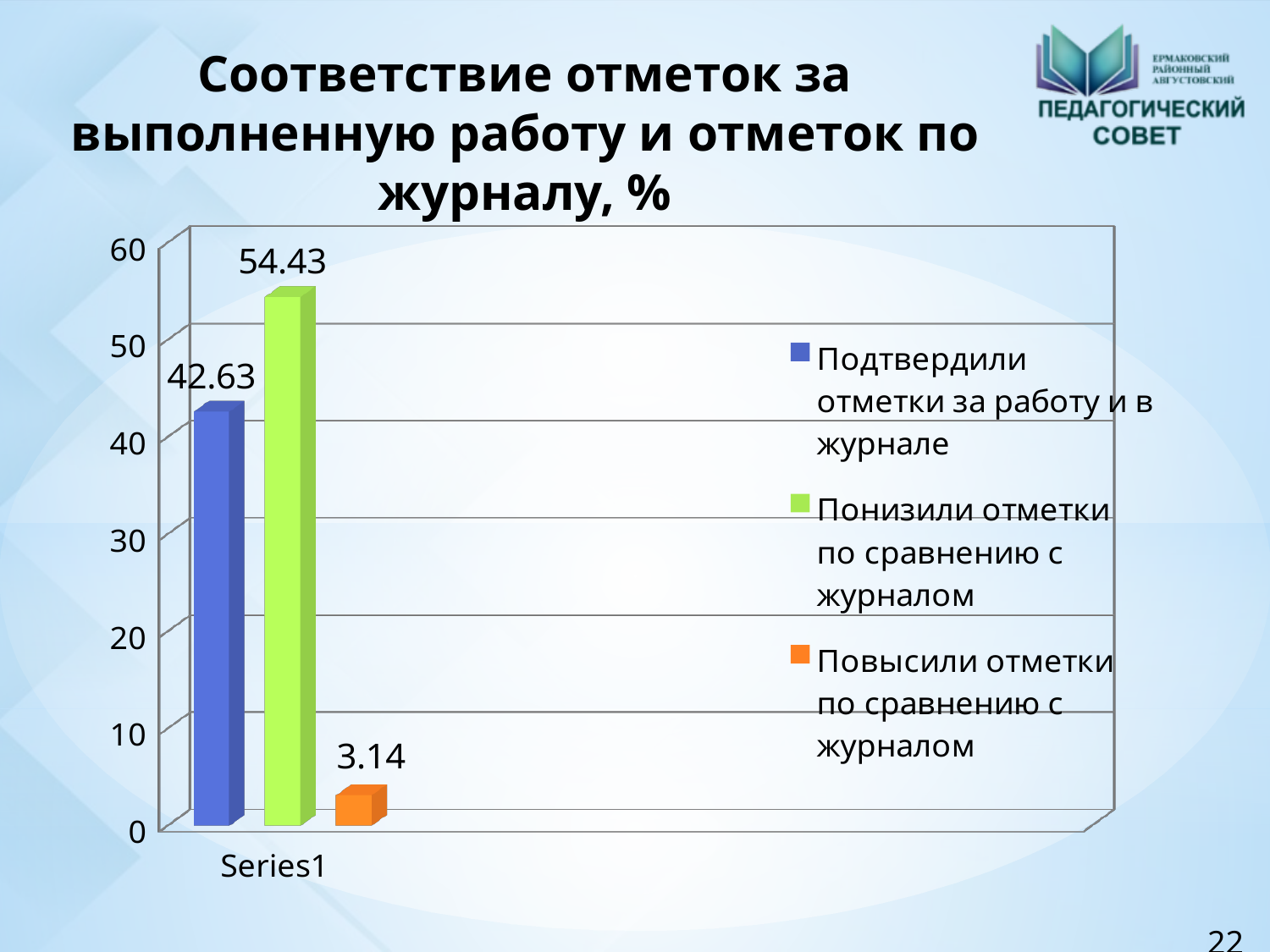
How many series does the legend list? 3 What value is shown for "Подтвердили отметки за работу и в журнале"? 42.63 Which series has the highest value? Понизили отметки по сравнению с журналом What kind of chart is shown on the slide? bar chart Is the value for "Подтвердили отметки за работу и в журнале" greater or less than 40? greater What value is shown for "Повысили отметки по сравнению с журналом"? 3.14 What is the difference between the values for "Понизили отметки по сравнению с журналом" and "Подтвердили отметки за работу и в журнале"? 11.8 What is the difference between the values for "Подтвердили отметки за работу и в журнале" and "Повысили отметки по сравнению с журналом"? 39.49 Which series has the lowest value? Повысили отметки по сравнению с журналом Which is larger: the value for "Подтвердили отметки за работу и в журнале" or for "Понизили отметки по сравнению с журналом"? Понизили отметки по сравнению с журналом What value is shown for "Понизили отметки по сравнению с журналом"? 54.43 What colour is the bar for "Повысили отметки по сравнению с журналом"? orange